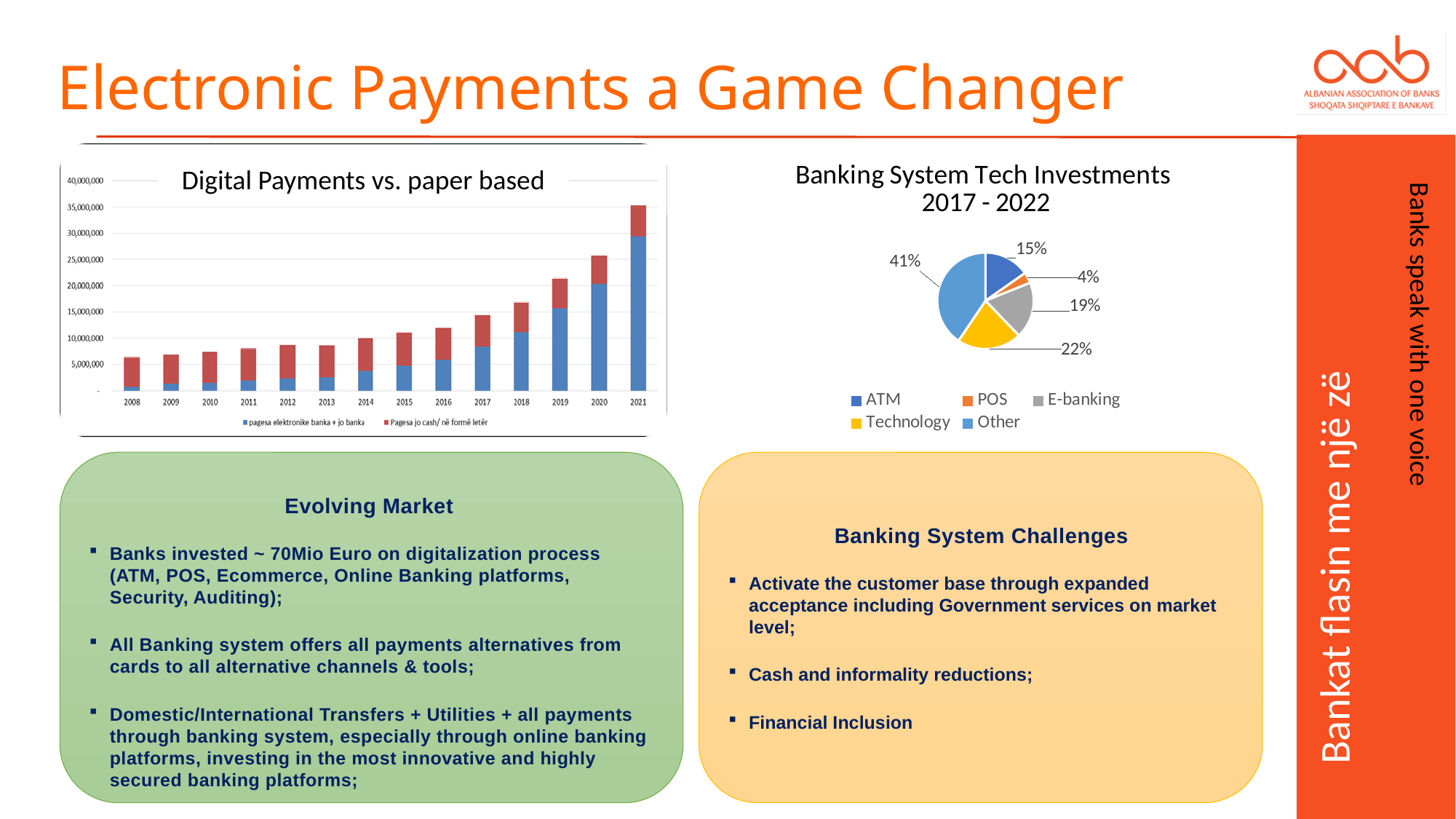
In the Banking System Tech Investments 2017 - 2022 pie chart, what is the difference between the Other share and the Technology share? 19% How many years are shown on the x axis of the Digital Payments vs. paper based chart? 14 In the Banking System Tech Investments 2017 - 2022 pie chart, what share is ATM? 15% In the Banking System Tech Investments 2017 - 2022 pie chart, what share is Technology? 22% In the Banking System Tech Investments 2017 - 2022 pie chart, how many categories does the legend list? 5 In the Banking System Tech Investments 2017 - 2022 pie chart, which category has the largest share? Other What kind of chart is the Digital Payments vs. paper based chart? Stacked bar chart How many series does the legend of the Digital Payments vs. paper based chart list? 2 In the Banking System Tech Investments 2017 - 2022 pie chart, what share is POS? 4% In the Banking System Tech Investments 2017 - 2022 pie chart, which category has the smallest share? POS In the Digital Payments vs. paper based chart, is the total value for 2021 greater or less than 30,000,000? greater